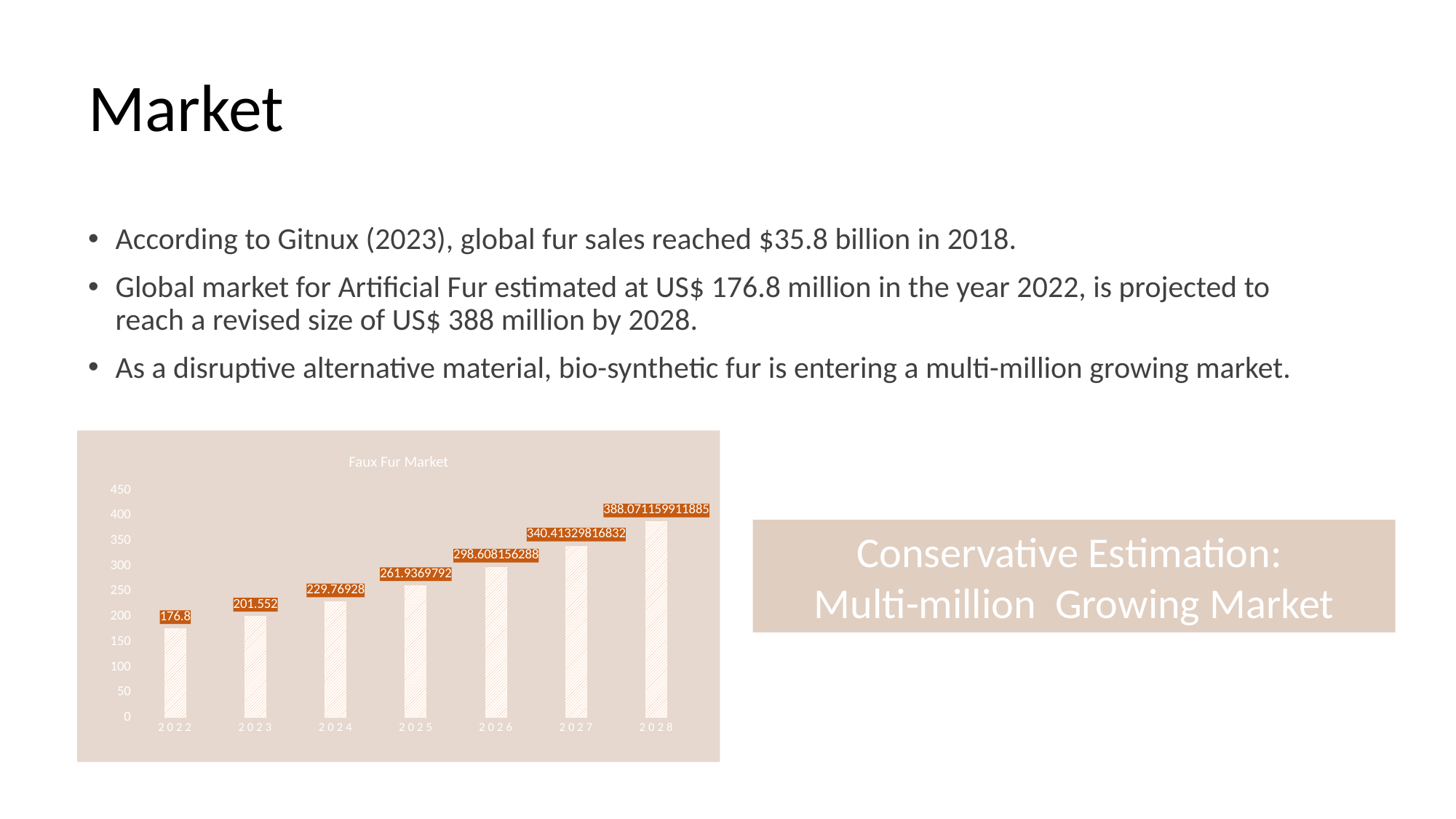
Do the values in the Faux Fur Market chart rise or fall from 2022 to 2028? rise What kind of chart is shown on the slide? bar chart What is the value for 2023 in the Faux Fur Market chart? 201.552 Which year has the lowest value in the Faux Fur Market chart? 2022 Which year has the highest value in the Faux Fur Market chart? 2028 Which is larger in the Faux Fur Market chart, the value for 2025 or the value for 2027? 2027 What is the value for 2022 in the Faux Fur Market chart? 176.8 How many years are shown on the x axis of the Faux Fur Market chart? 7 What is the value for 2028 in the Faux Fur Market chart? 388.071159911885 What is the value for 2024 in the Faux Fur Market chart? 229.76928 What is the title of the chart? Faux Fur Market Is the value for 2026 in the Faux Fur Market chart greater or less than 250? greater